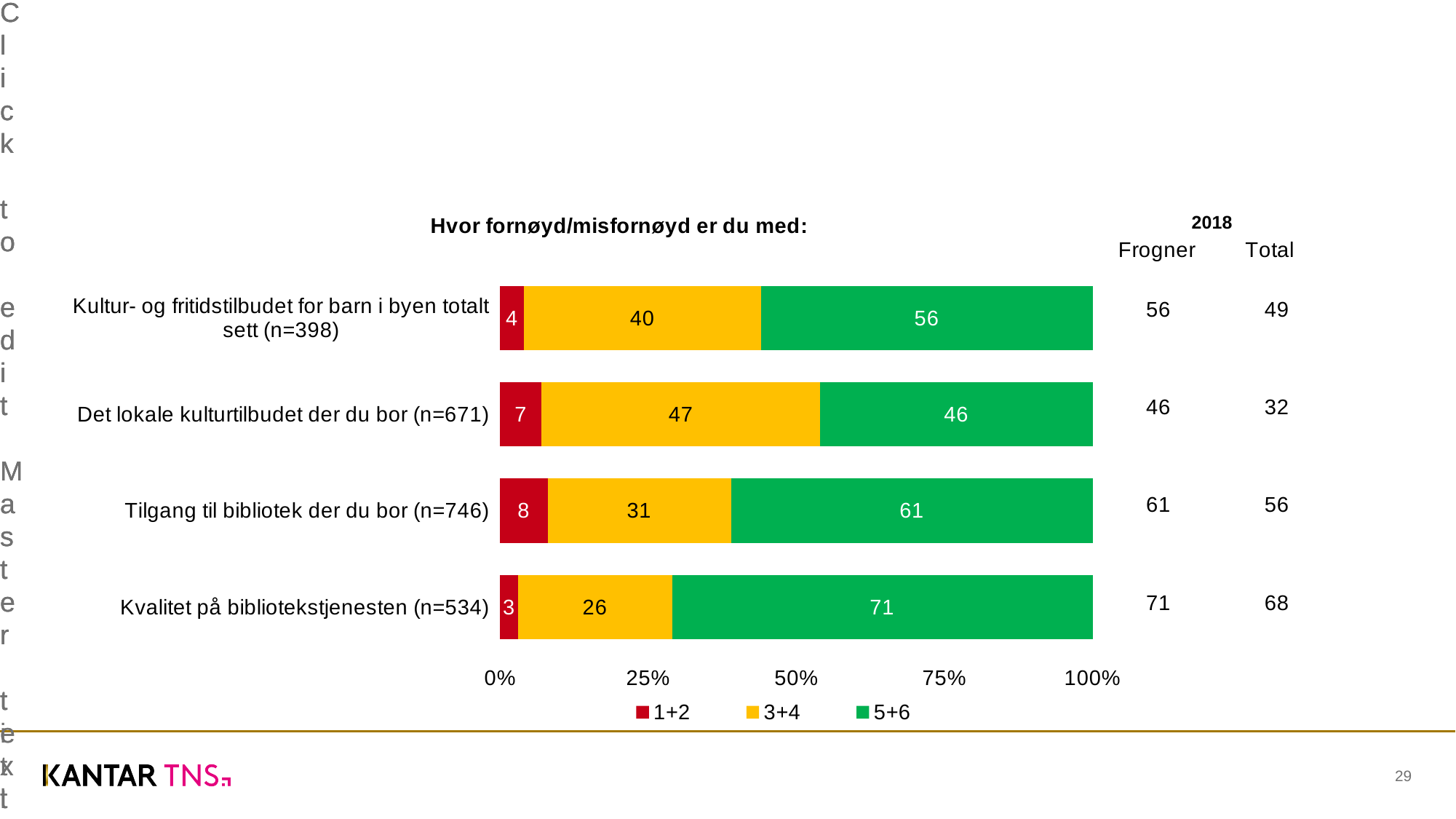
What is the title of the chart? Hvor fornøyd/misfornøyd er du med: Which category has the highest value for the 5+6 series? Kvalitet på bibliotekstjenesten (n=534) What is the value of the 3+4 series for "Det lokale kulturtilbudet der du bor (n=671)"? 47 What is the total of the stacked bar for "Det lokale kulturtilbudet der du bor (n=671)"? 100 What kind of chart is shown on the slide? Stacked bar chart Which category has the lowest value for the 1+2 series? Kvalitet på bibliotekstjenesten (n=534) What is the value of the 5+6 series for "Kvalitet på bibliotekstjenesten (n=534)"? 71 What is the difference between the 5+6 values for "Tilgang til bibliotek der du bor (n=746)" and "Det lokale kulturtilbudet der du bor (n=671)"? 15 Which is larger: the 3+4 value for "Kultur- og fritidstilbudet for barn i byen totalt sett (n=398)" or the 3+4 value for "Tilgang til bibliotek der du bor (n=746)"? Kultur- og fritidstilbudet for barn i byen totalt sett (n=398) What is the value of the 1+2 series for "Tilgang til bibliotek der du bor (n=746)"? 8 How many categories are shown in the chart? 4 How many series does the legend list? 3